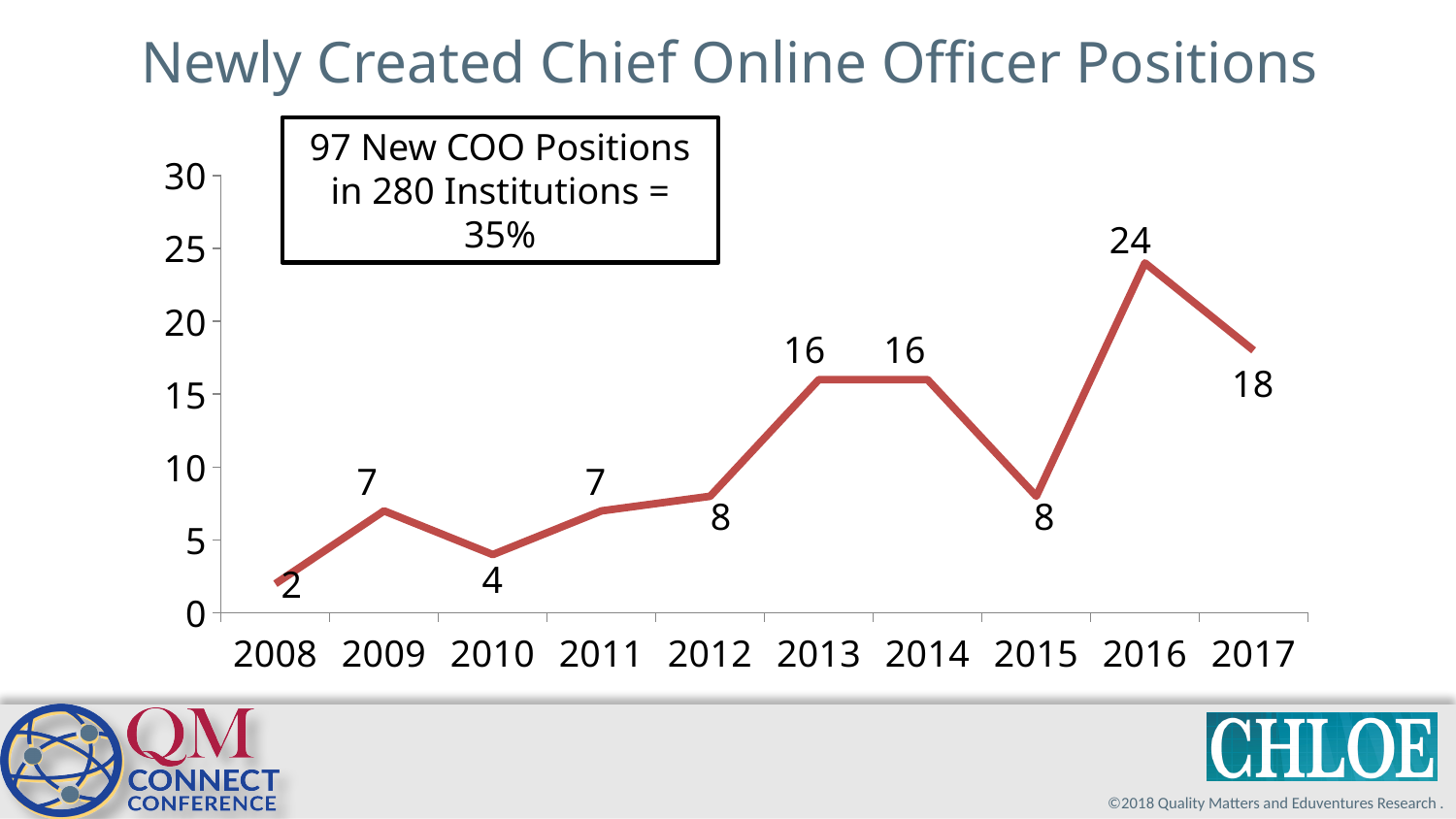
Which is larger, the value for 2013 or the value for 2015? 2013 Which year has the highest value? 2016 Which year has the lowest value? 2008 What is the title of the chart? Newly Created Chief Online Officer Positions What is the difference between the values for 2016 and 2017? 6 What is the value for 2008? 2 What is the value for 2012? 8 What is the difference between the values for 2015 and 2016? 16 What is the value for 2016? 24 What kind of chart is shown? line chart Is the value for 2017 greater or less than 15? greater How many years are plotted on the x axis? 10